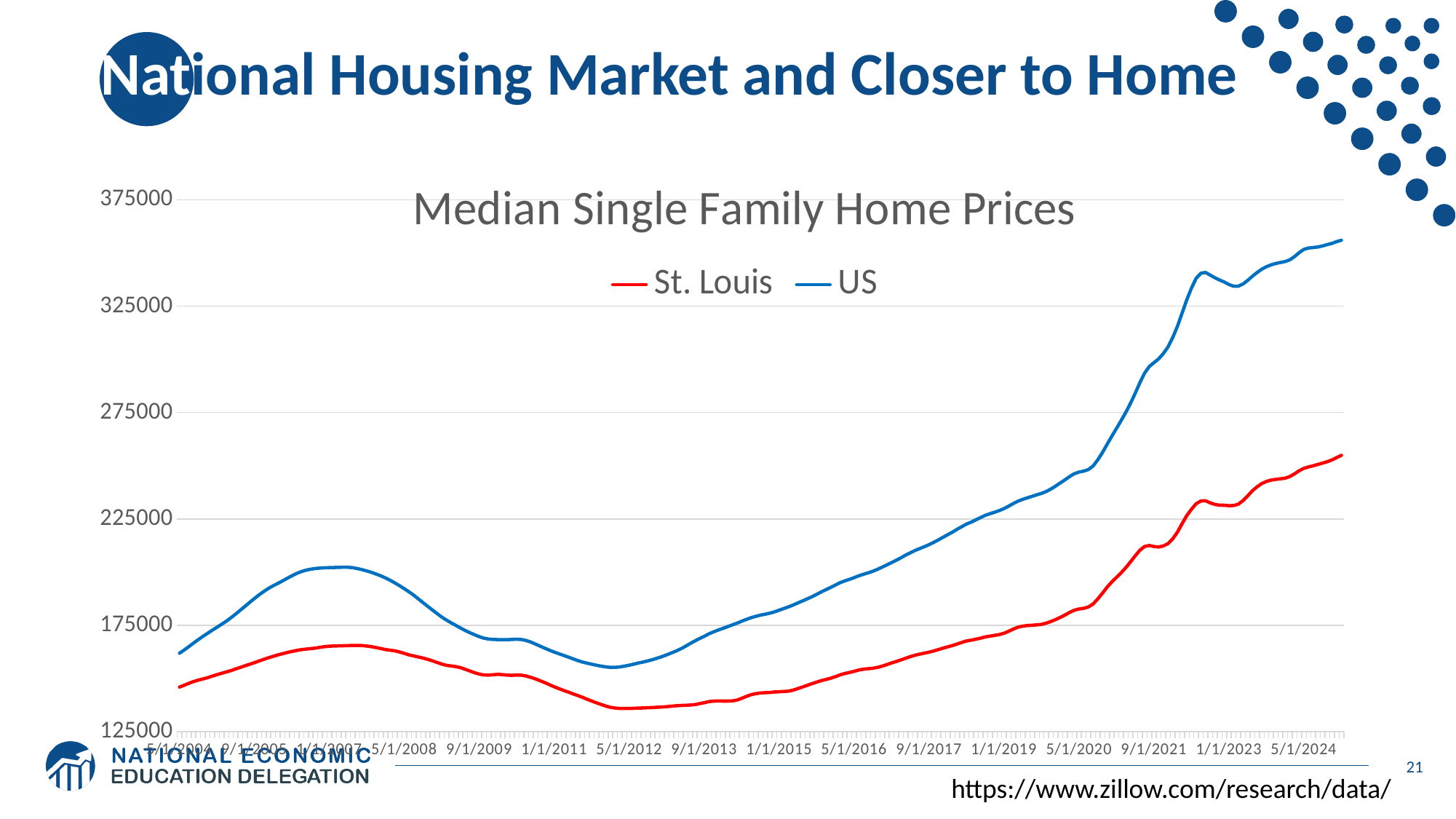
Overall, do the US median home prices rise or fall from 5/1/2012 to 5/1/2024? rise At 5/1/2024, which series has the higher median home price, St. Louis or US? US Is the US value at 5/1/2012 greater or less than 175000? less Is the US value at 1/1/2007 greater or less than 175000? greater What kind of chart is shown on the slide? line chart How many series does the legend of the Median Single Family Home Prices chart list? 2 Is the US value at 5/1/2024 greater or less than 325000? greater What is the title of the chart on the slide? Median Single Family Home Prices Which colour is used for the St. Louis series in the chart? red Which series is lower than the other across the entire period shown, St. Louis or US? St. Louis